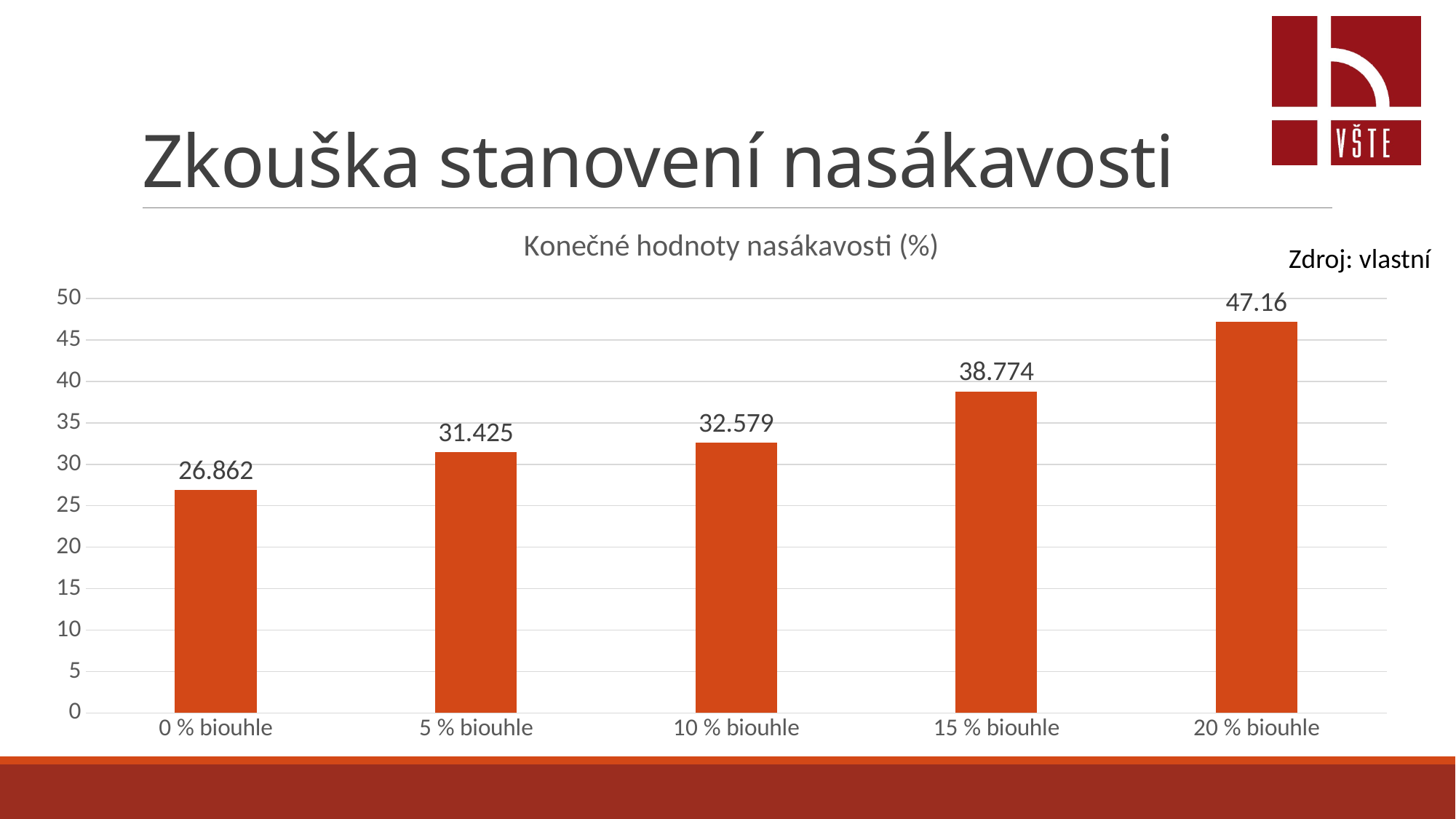
Which category has the highest value? 20 % biouhle What is the value for 0 % biouhle? 26.862 Is the value for 5 % biouhle greater or less than 30? greater How many categories are shown on the x axis? 5 Which category has the lowest value? 0 % biouhle What is the value for 20 % biouhle? 47.16 Which is larger, the value for 15 % biouhle or the value for 10 % biouhle? 15 % biouhle Do the values rise or fall from 0 % biouhle to 20 % biouhle? rise What is the difference between the values for 10 % biouhle and 5 % biouhle? 1.154 What is the difference between the values for 20 % biouhle and 0 % biouhle? 20.298 What is the value for 15 % biouhle? 38.774 What kind of chart is shown on the slide? bar chart